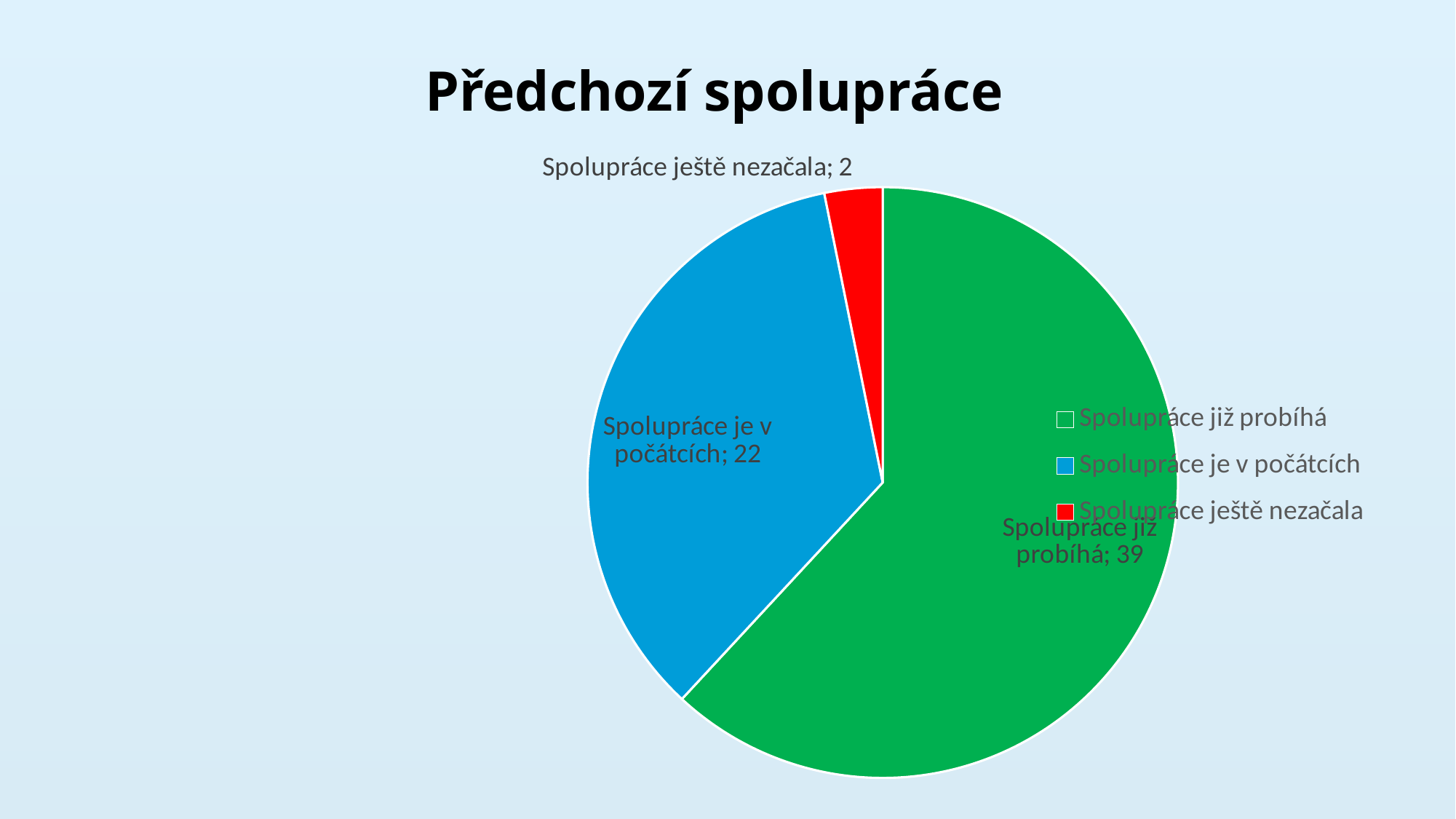
Which category has the largest slice of the pie? Spolupráce již probíhá What colour is the slice for 'Spolupráce ještě nezačala'? red What is the value for 'Spolupráce ještě nezačala'? 2 Which category has the smallest slice of the pie? Spolupráce ještě nezačala What is the total of all the values in the pie chart? 63 What is the title of the chart? Předchozí spolupráce Which is larger: 'Spolupráce je v počátcích' or 'Spolupráce ještě nezačala'? Spolupráce je v počátcích How many categories does the pie chart have? 3 What is the value for 'Spolupráce již probíhá'? 39 What type of chart is shown on the slide? pie chart What is the value for 'Spolupráce je v počátcích'? 22 What is the difference between the values for 'Spolupráce již probíhá' and 'Spolupráce je v počátcích'? 17